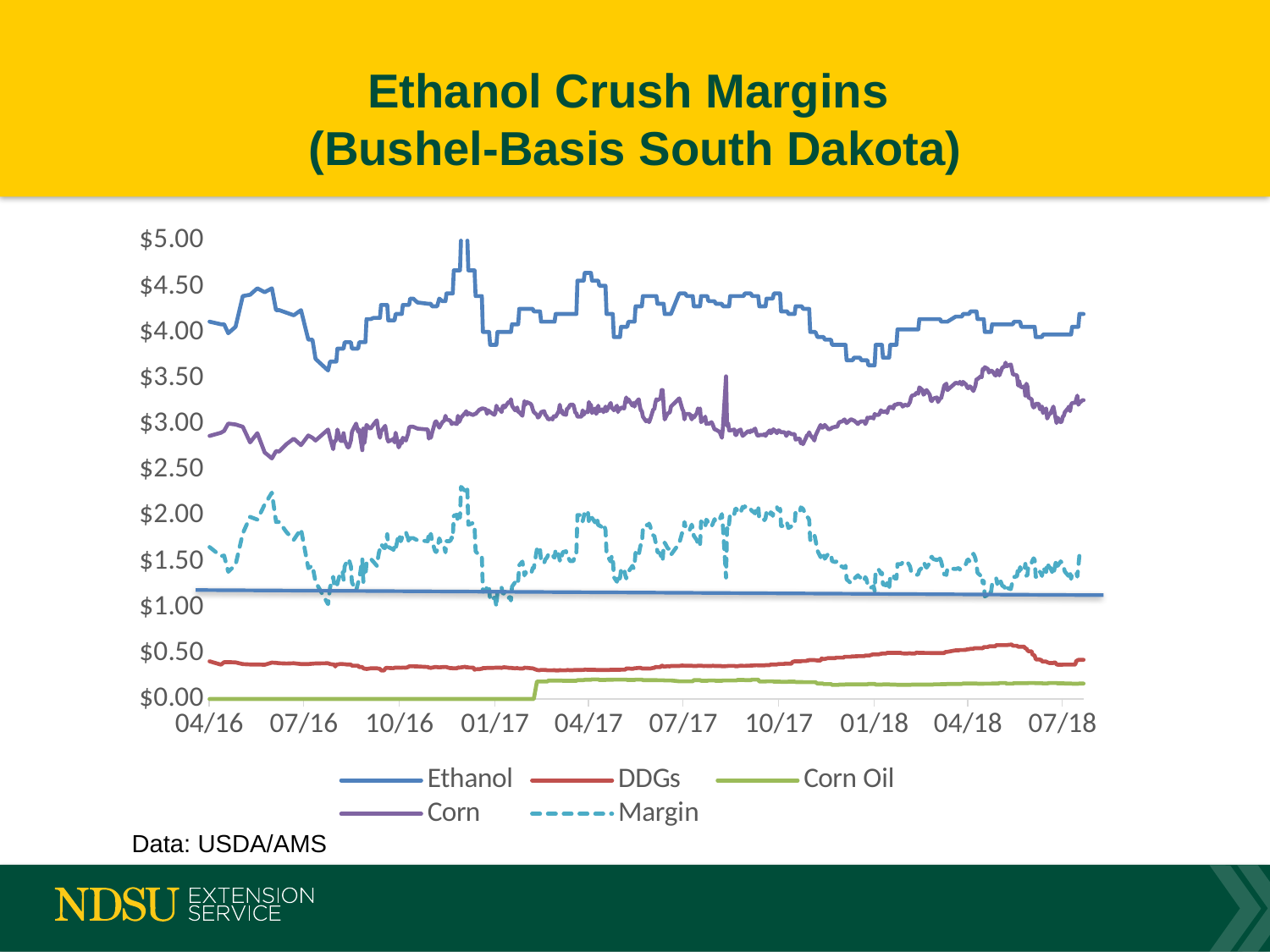
How many series does the legend list? 5 How many date labels are shown on the x axis? 10 Which series is drawn with a dashed line? Margin Which series has the highest values across the chart? Ethanol Is the value for Corn at 07/18 greater or less than $2.50? greater Is the value for DDGs at 01/18 greater or less than $1.00? less At 07/18, which is larger: DDGs or Corn Oil? DDGs What is the title of the chart? Ethanol Crush Margins (Bushel-Basis South Dakota) Is the value for Margin at 07/18 greater or less than $2.00? less At 01/18, which is larger: Corn or DDGs? Corn What kind of chart is shown on the slide? line chart